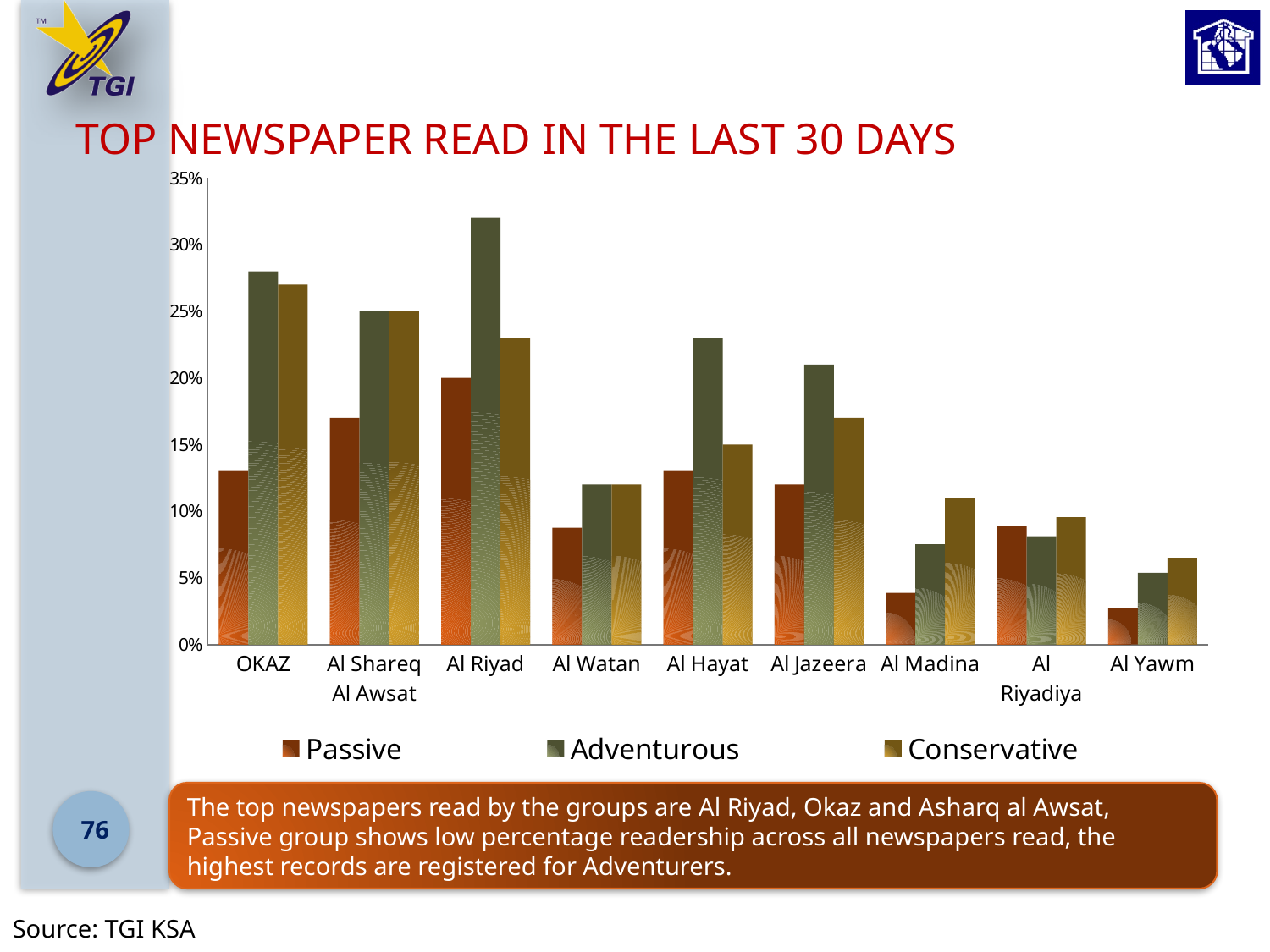
How many newspapers are shown on the x axis? 9 Which newspaper has the lowest Passive value? Al Yawm What kind of chart is shown on the slide? bar chart Is the Adventurous value for Al Hayat greater or less than 20%? greater How many series does the legend list? 3 Is the Adventurous value for Al Riyad greater or less than 30%? greater Is the Passive value for Al Madina greater or less than 5%? less For Al Madina, which is larger: the Conservative value or the Adventurous value? Conservative Which newspaper has the highest Adventurous value? Al Riyad What are the three series listed in the legend? Passive, Adventurous, Conservative For OKAZ, which is larger: the Passive value or the Adventurous value? Adventurous What is the title of the chart? TOP NEWSPAPER READ IN THE LAST 30 DAYS